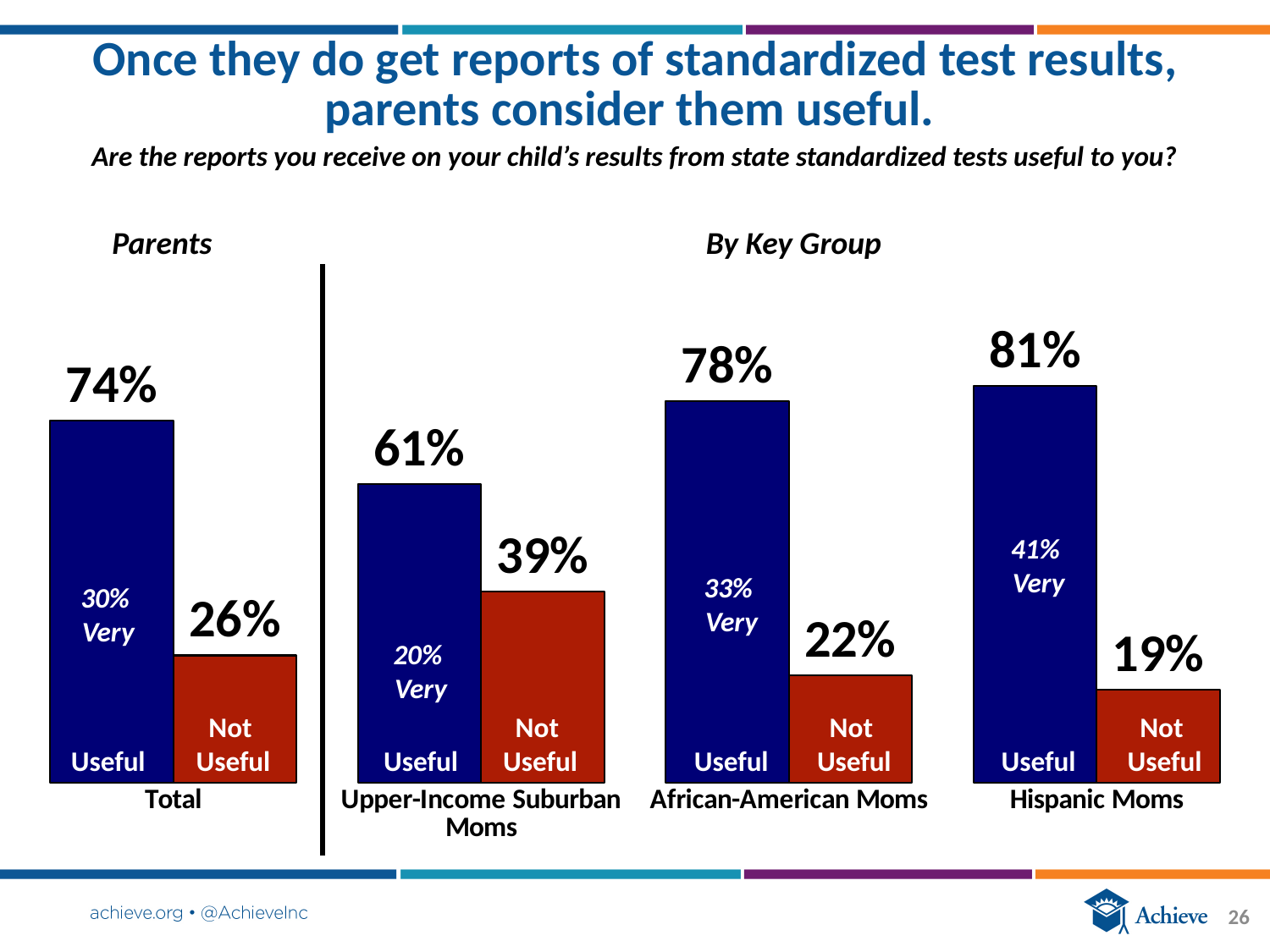
What type of chart is shown on the slide? Bar chart How many groups are shown on the chart? 4 What is the difference between the Useful and Not Useful percentages for African-American Moms? 56 percentage points Which group has the lowest Useful percentage? Upper-Income Suburban Moms What is the 'Very' useful percentage for Upper-Income Suburban Moms? 20% What colour are the Not Useful bars? Red What percentage of Hispanic Moms say the reports are useful? 81% What is the Not Useful value for Upper-Income Suburban Moms? 39% Is the Not Useful value larger for the Total group or for Hispanic Moms? Total What share of African-American Moms say the reports are 'Very' useful? 33% Which group has the highest Useful percentage? Hispanic Moms What percentage of parents in the Total group say the reports are useful? 74%